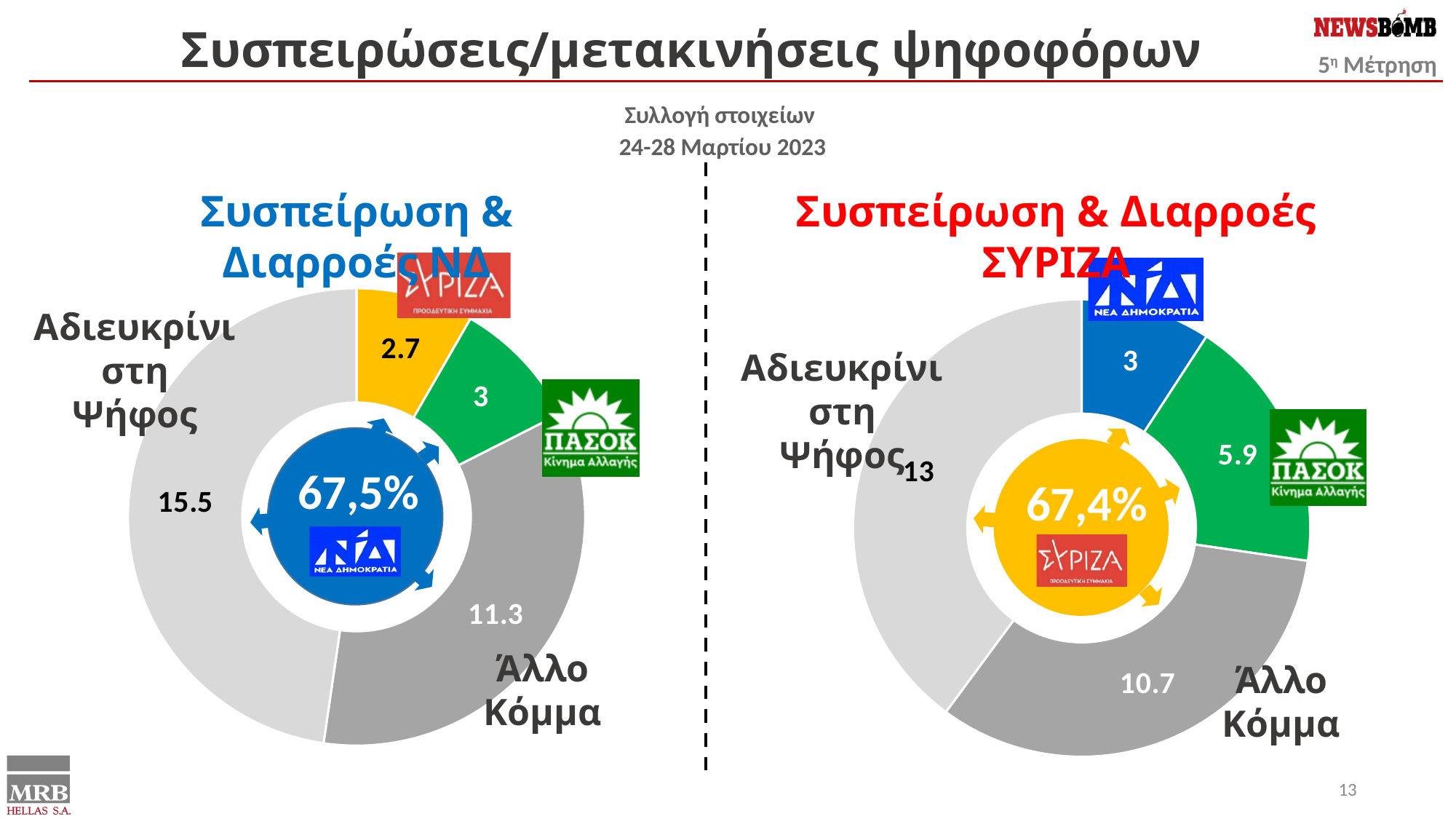
In the left chart (Συσπείρωση & Διαρροές ΝΔ), what value is shown for the ΣΥΡΙΖΑ slice? 2.7 In the left chart (Συσπείρωση & Διαρροές ΝΔ), which labelled slice has the smallest value? ΣΥΡΙΖΑ (2.7) Which is larger: the ΠΑΣΟΚ value in the left chart (ΝΔ) or the ΠΑΣΟΚ value in the right chart (ΣΥΡΙΖΑ)? The right chart (ΣΥΡΙΖΑ), 5.9 In the right chart (Συσπείρωση & Διαρροές ΣΥΡΙΖΑ), which labelled slice has the largest value? Αδιευκρίνιστη Ψήφος (13) What percentage is printed in the centre of the right chart (Συσπείρωση & Διαρροές ΣΥΡΙΖΑ)? 67,4% In the right chart (Συσπείρωση & Διαρροές ΣΥΡΙΖΑ), what value is shown for ΠΑΣΟΚ? 5.9 In the left chart (Συσπείρωση & Διαρροές ΝΔ), what value is shown for Αδιευκρίνιστη Ψήφος? 15.5 In the left chart (Συσπείρωση & Διαρροές ΝΔ), what value is shown for Άλλο Κόμμα? 11.3 What type of chart is used on the left side of the slide (Συσπείρωση & Διαρροές ΝΔ)? Pie (donut) chart In the right chart (Συσπείρωση & Διαρροές ΣΥΡΙΖΑ), what is the difference between Αδιευκρίνιστη Ψήφος and Άλλο Κόμμα? 2.3 In the right chart (Συσπείρωση & Διαρροές ΣΥΡΙΖΑ), what value is shown for Άλλο Κόμμα? 10.7 What percentage is printed in the centre of the left chart (Συσπείρωση & Διαρροές ΝΔ)? 67,5%